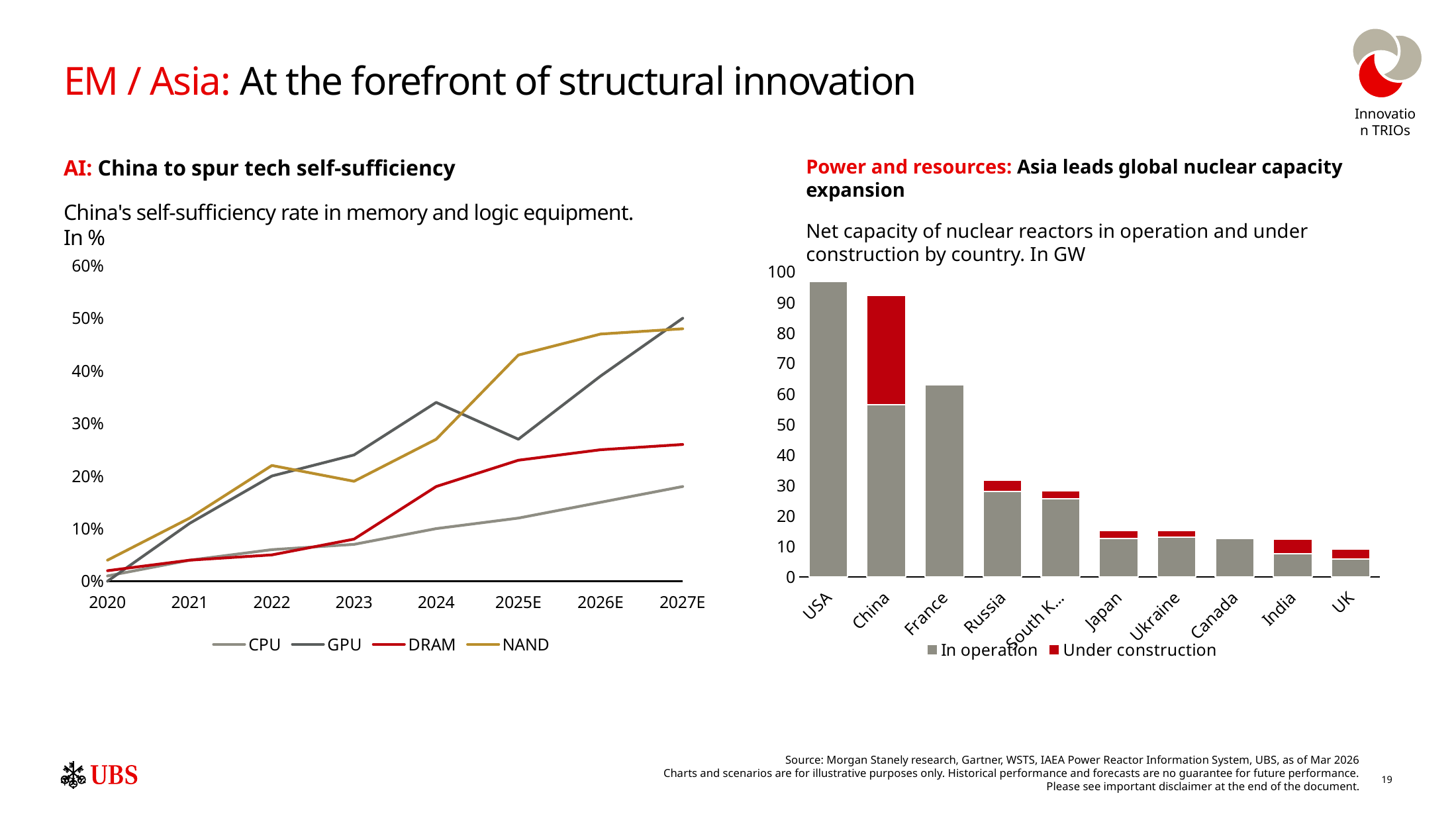
On the right chart (net capacity of nuclear reactors), what kind of chart is it? stacked bar chart On the left chart (China's self-sufficiency rate), does the CPU line rise or fall from 2020 to 2027E? rise On the left chart (China's self-sufficiency rate), how many series does the legend list? 4 On the right chart (net capacity of nuclear reactors), is the total value for France greater or less than 60? greater On the left chart (China's self-sufficiency rate), how many years are shown on the x axis? 8 On the left chart (China's self-sufficiency rate), what kind of chart is it? line chart On the left chart (China's self-sufficiency rate), is the CPU value for 2027E greater or less than 20%? less On the left chart (China's self-sufficiency rate), which series has the lowest value in 2027E? CPU On the right chart (net capacity of nuclear reactors), how many countries are shown? 10 On the right chart (net capacity of nuclear reactors), which country has the highest total capacity? USA On the left chart (China's self-sufficiency rate), which series has the highest value in 2025E? NAND On the left chart (China's self-sufficiency rate), is the NAND value for 2025E greater or less than 40%? greater